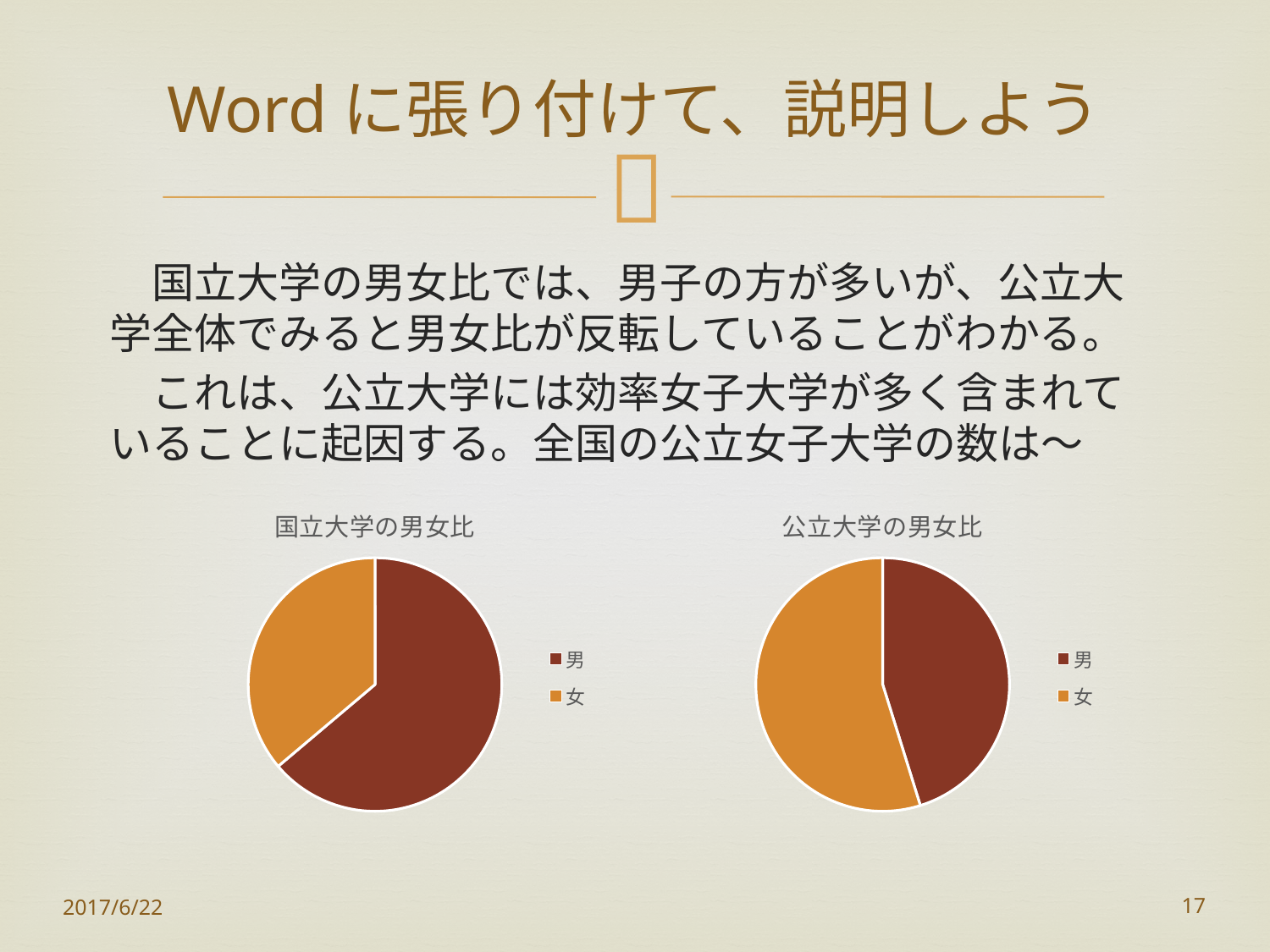
In the left chart 国立大学の男女比, which category has the smallest slice? 女 What kind of chart is the right chart titled 公立大学の男女比? pie chart In the left chart 国立大学の男女比, which is larger, the slice for 男 or the slice for 女? 男 In the left chart 国立大学の男女比, how many slices does the pie have? 2 In the right chart 公立大学の男女比, how many categories does the legend list? 2 In the left chart 国立大学の男女比, which category has the largest slice? 男 What is the title of the left pie chart? 国立大学の男女比 In the right chart 公立大学の男女比, which is larger, the slice for 男 or the slice for 女? 女 What kind of chart is the left chart titled 国立大学の男女比? pie chart In the right chart 公立大学の男女比, which category has the largest slice? 女 In the right chart 公立大学の男女比, which category has the smallest slice? 男 In the right chart 公立大学の男女比, what colour is the slice for 女? orange